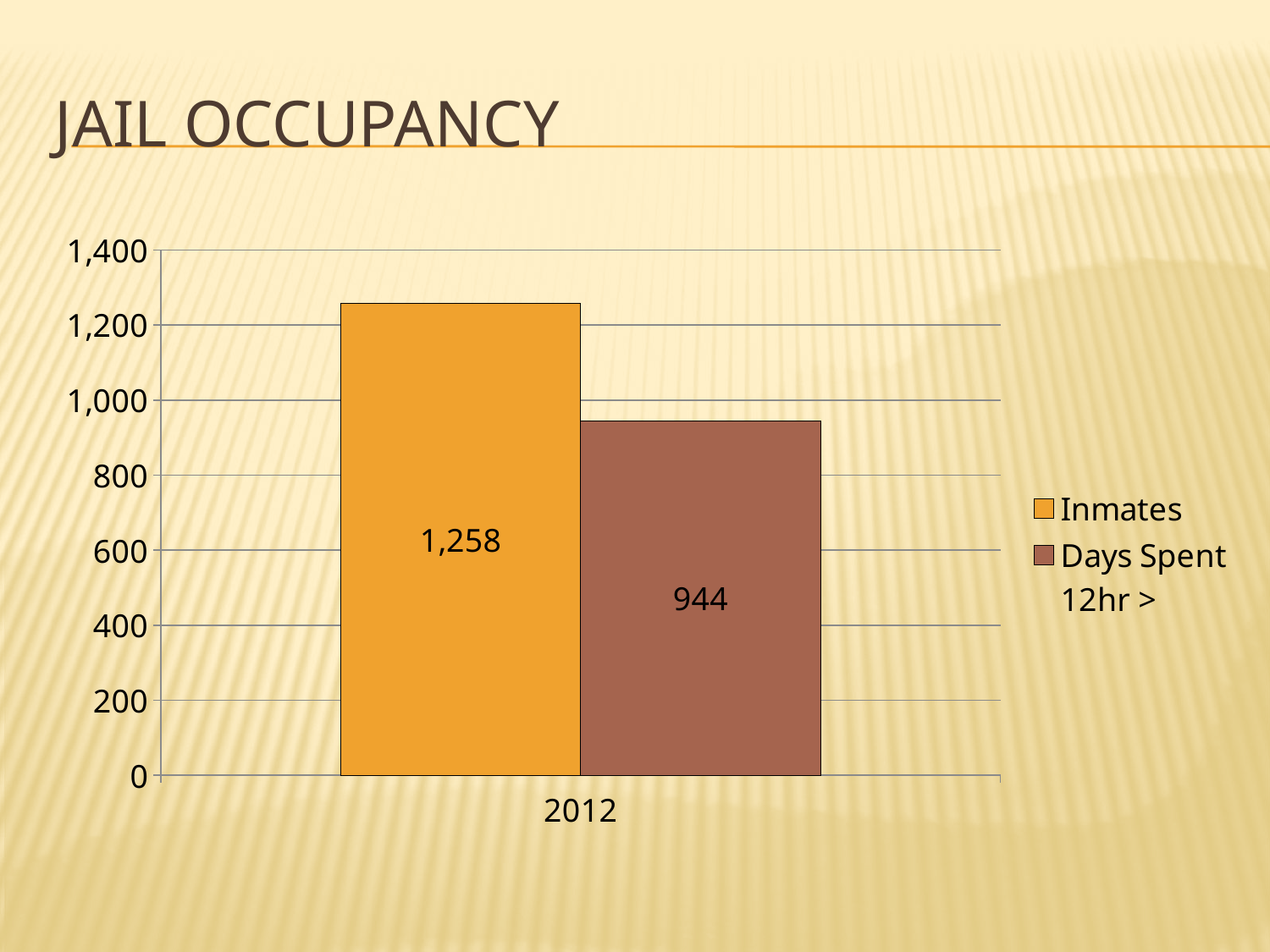
How many categories are shown on the x axis? 1 Which series is shown in orange? Inmates How many series does the legend list? 2 Is the value for Days Spent 12hr > greater or less than 1,000? less What year is shown on the x axis? 2012 What is the value for Days Spent 12hr > in 2012? 944 Is the value for Inmates greater or less than 1,200? greater Which series has the higher value in 2012, Inmates or Days Spent 12hr >? Inmates What is the value for Inmates in 2012? 1,258 What is the difference between the Inmates value and the Days Spent 12hr > value in 2012? 314 What is the title of the slide? JAIL OCCUPANCY What kind of chart is shown on the slide? bar chart